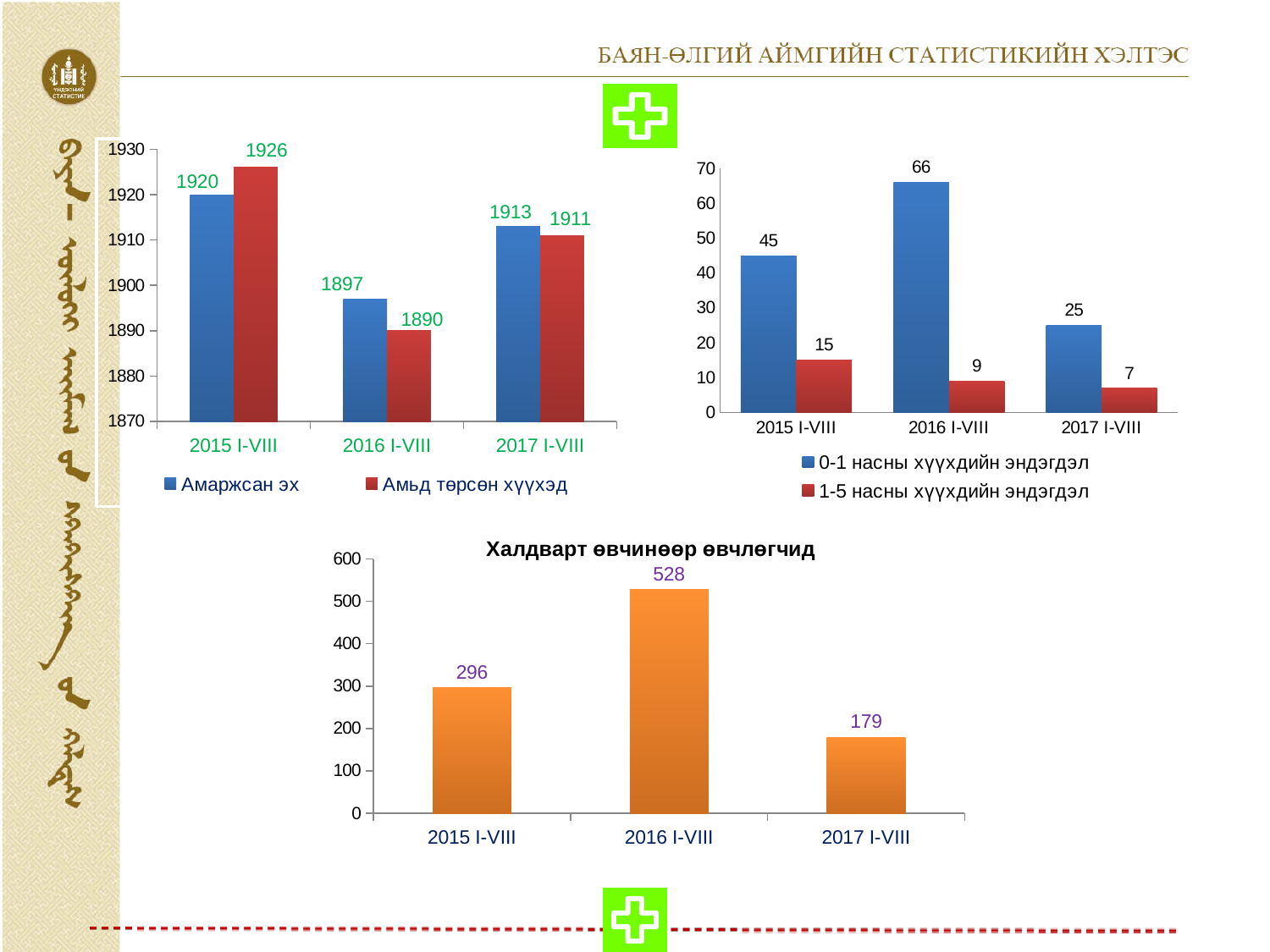
In the top-left chart, what is the difference between Амаржсан эх and Амьд төрсөн хүүхэд in 2017 I-VIII? 2 In the chart titled Халдварт өвчинөөр өвчлөгчид, which period has the lowest value? 2017 I-VIII In the top-right chart, what is the value for 0-1 насны хүүхдийн эндэгдэл in 2016 I-VIII? 66 In the top-left chart, what is the value for Амьд төрсөн хүүхэд in 2016 I-VIII? 1890 In the top-left chart, what is the value for Амаржсан эх in 2015 I-VIII? 1920 In the chart titled Халдварт өвчинөөр өвчлөгчид, what is the difference between 2016 I-VIII and 2015 I-VIII? 232 In the top-left chart, how many series does the legend list? 2 In the top-right chart, what is the value for 1-5 насны хүүхдийн эндэгдэл in 2017 I-VIII? 7 In the top-right chart, what is the difference between the 0-1 and 1-5 age group values in 2015 I-VIII? 30 In the top-right chart, which period has the highest value for 0-1 насны хүүхдийн эндэгдэл? 2016 I-VIII What kind of chart is the chart titled Халдварт өвчинөөр өвчлөгчид? Bar chart In the chart titled Халдварт өвчинөөр өвчлөгчид, what is the value for 2016 I-VIII? 528